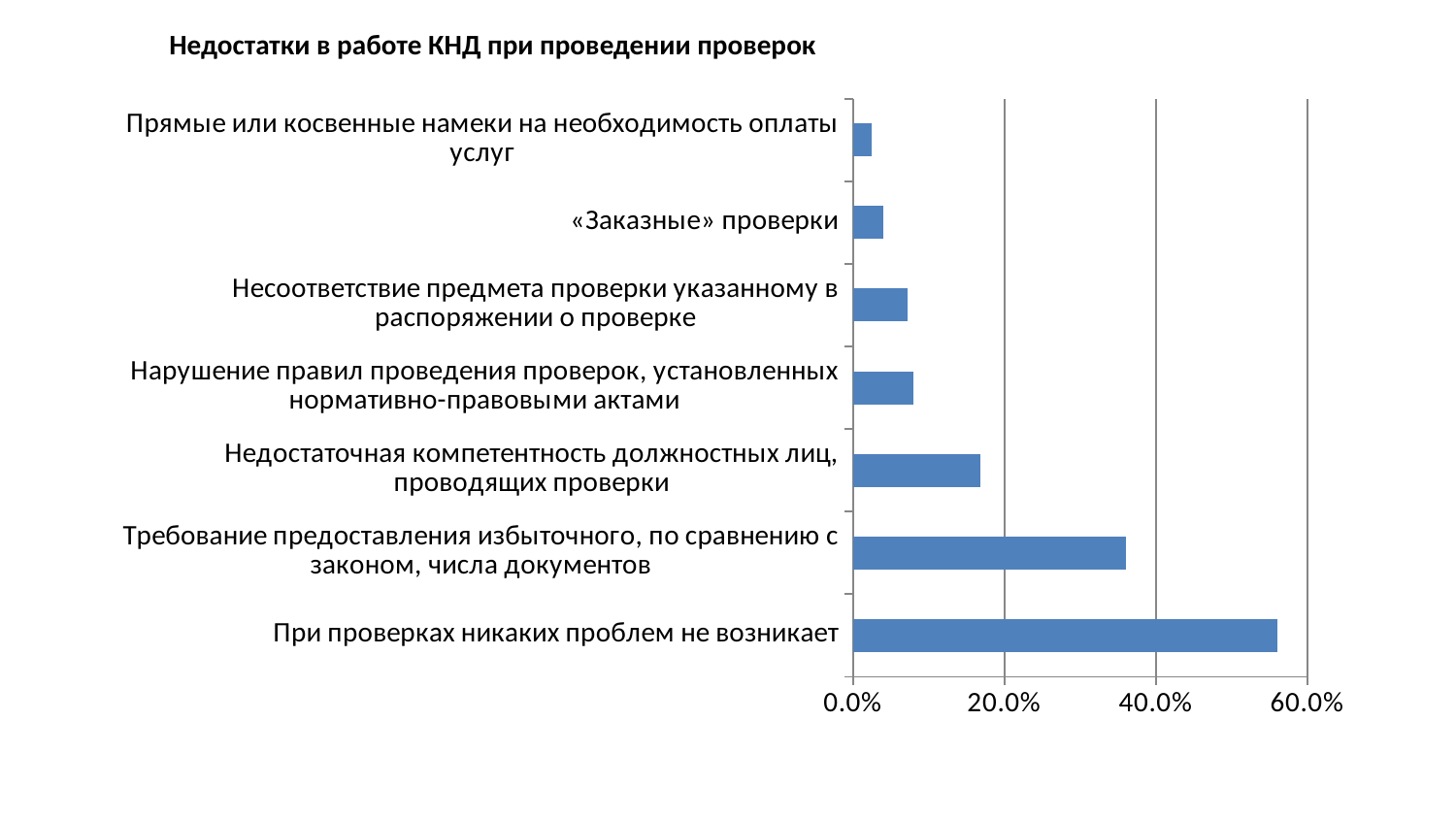
Which category has the highest value? При проверках никаких проблем не возникает Is the value for "Требование предоставления избыточного, по сравнению с законом, числа документов" greater or less than 20.0%? greater How many categories are plotted in the chart? 7 Which category has the lowest value? Прямые или косвенные намеки на необходимость оплаты услуг What is the highest value shown on the horizontal axis of the chart? 60.0% Which is larger: the value for "Требование предоставления избыточного, по сравнению с законом, числа документов" or for "«Заказные» проверки"? Требование предоставления избыточного, по сравнению с законом, числа документов Is the value for "Недостаточная компетентность должностных лиц, проводящих проверки" greater or less than 20.0%? less Which is larger: the value for "Недостаточная компетентность должностных лиц, проводящих проверки" or for "Нарушение правил проведения проверок, установленных нормативно-правовыми актами"? Недостаточная компетентность должностных лиц, проводящих проверки Is the value for "При проверках никаких проблем не возникает" greater or less than 40.0%? greater What is the title of the chart? Недостатки в работе КНД при проведении проверок What kind of chart is shown on the slide? bar chart